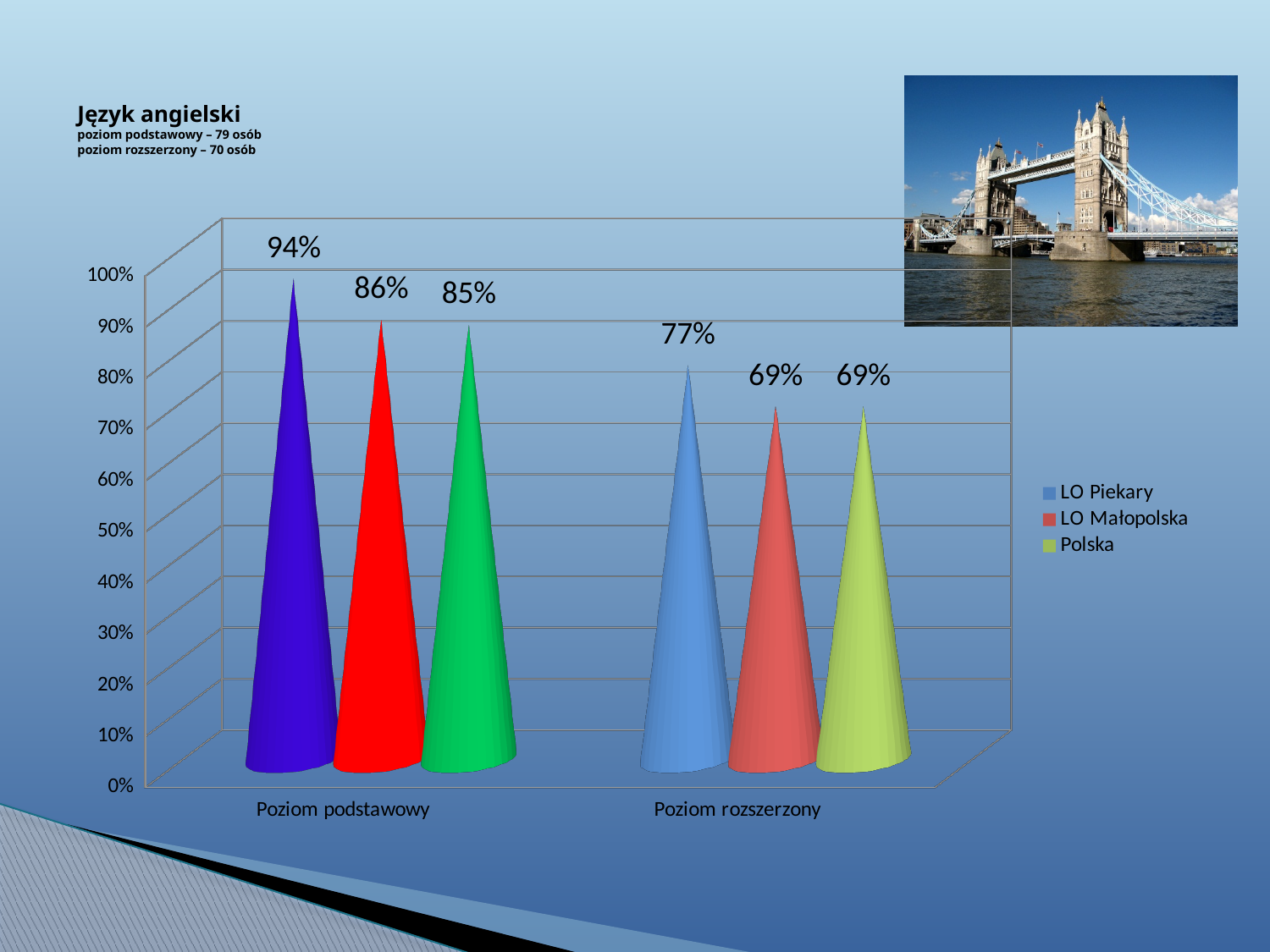
What is the difference between LO Piekary and LO Małopolska at Poziom rozszerzony? 8% What is the value for LO Piekary at Poziom rozszerzony? 77% Which series has the highest value at Poziom rozszerzony? LO Piekary How many categories are shown on the x axis? 2 Which series has the highest value at Poziom podstawowy? LO Piekary How many series does the legend list? 3 What is the difference between LO Piekary and Polska at Poziom podstawowy? 9% Which is larger: LO Małopolska at Poziom podstawowy or LO Małopolska at Poziom rozszerzony? Poziom podstawowy What kind of chart is shown on the slide? Bar chart What is the value for LO Piekary at Poziom podstawowy? 94% What is the value for LO Małopolska at Poziom rozszerzony? 69% What is the value for Polska at Poziom podstawowy? 85%